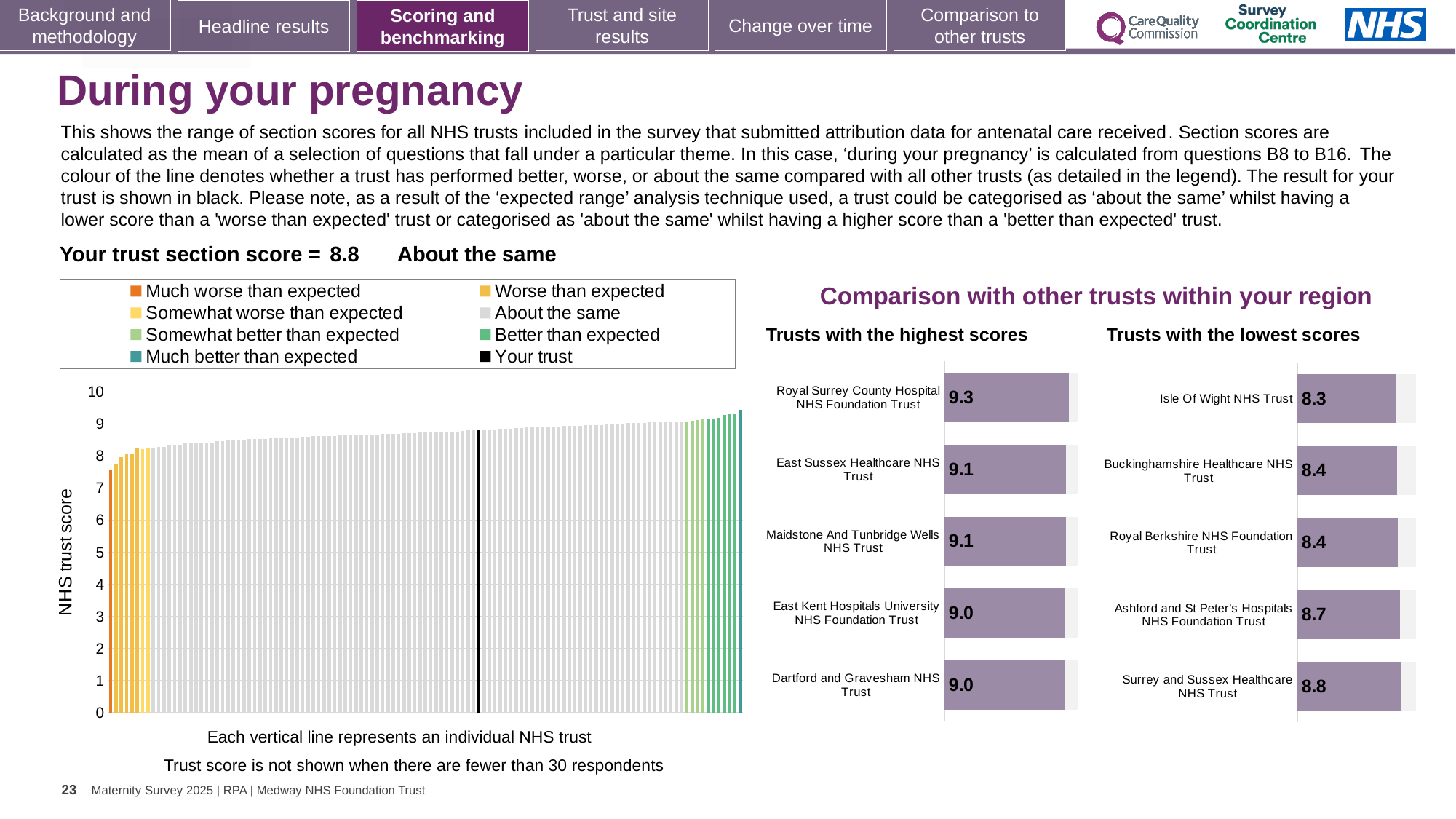
In the 'Trusts with the lowest scores' chart, what is the score for Isle Of Wight NHS Trust? 8.3 In the 'Trusts with the highest scores' chart, which trust has the highest score? Royal Surrey County Hospital NHS Foundation Trust In the 'Trusts with the highest scores' chart, what is the difference between the scores of Royal Surrey County Hospital NHS Foundation Trust and Dartford and Gravesham NHS Trust? 0.3 In the 'Trusts with the lowest scores' chart, what is the score for Surrey and Sussex Healthcare NHS Trust? 8.8 What kind of chart is the NHS trust score chart on the left of the slide? Bar chart In the 'Trusts with the highest scores' chart, what is the score for Royal Surrey County Hospital NHS Foundation Trust? 9.3 In the NHS trust score chart on the left, is the value for the black 'Your trust' bar greater or less than 8? greater In the NHS trust score chart on the left, do the values rise or fall from left to right? Rise In the 'Trusts with the lowest scores' chart, which has the larger score: Ashford and St Peter's Hospitals NHS Foundation Trust or Buckinghamshire Healthcare NHS Trust? Ashford and St Peter's Hospitals NHS Foundation Trust How many entries does the legend of the NHS trust score chart list? 8 In the 'Trusts with the lowest scores' chart, which trust has the lowest score? Isle Of Wight NHS Trust How many trusts are shown in the 'Trusts with the highest scores' chart? 5